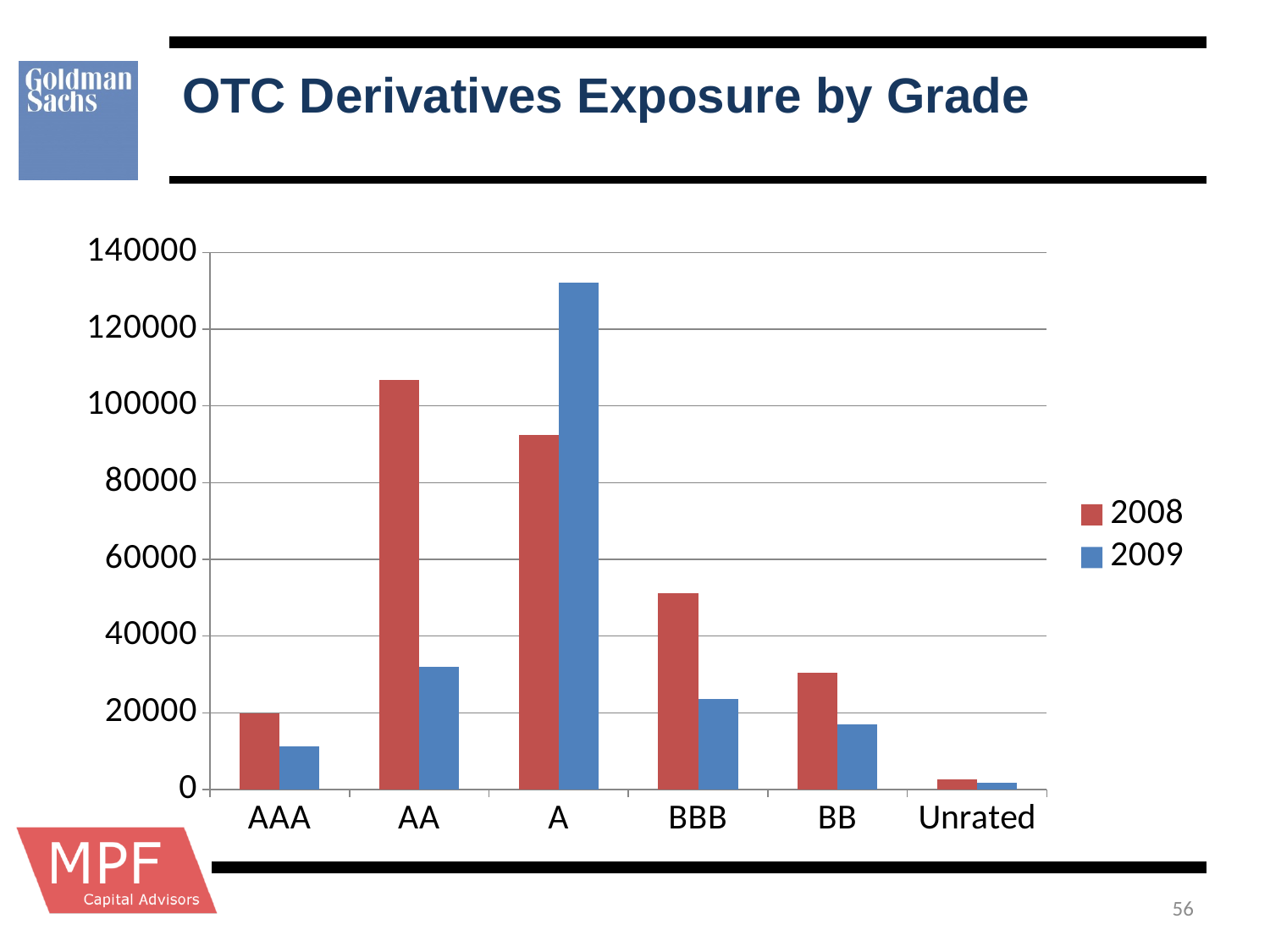
Which grade has the highest 2009 value? A For grade AA, which year has the larger value, 2008 or 2009? 2008 Which grade has the highest 2008 value? AA How many series does the legend list? 2 Is the 2009 value for A greater or less than 120000? greater How many grade categories are shown on the x axis? 6 Which grade has the lowest 2008 value? Unrated What kind of chart is shown on the slide? bar chart Is the 2009 value for BB greater or less than 20000? less Is the 2008 value for AA greater or less than 100000? greater For grade A, which year has the larger value, 2008 or 2009? 2009 What is the title of the chart on the slide? OTC Derivatives Exposure by Grade